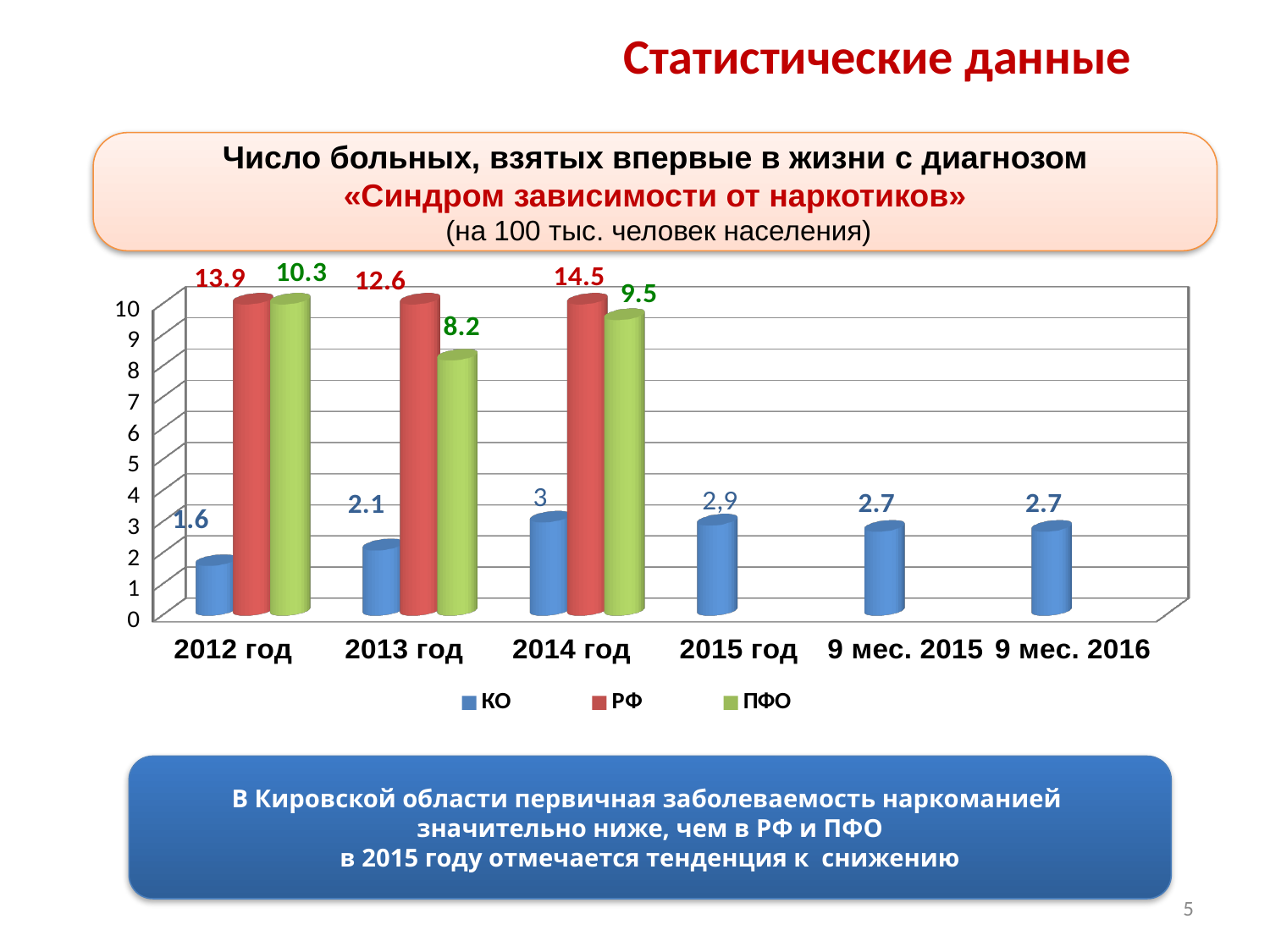
What kind of chart is shown on the slide? Bar chart What is the value for РФ in 2012 год? 13.9 How many categories are shown on the x axis? 6 How many series does the legend list? 3 What is the value for ПФО in 2013 год? 8.2 Which series is shown in red in the legend? РФ In which year is the РФ value highest? 2014 год In which category is the КО value lowest? 2012 год Which is larger in 2013 год: the РФ value or the ПФО value? РФ What is the value for КО in 9 мес. 2016? 2.7 What is the value for КО in 2015 год? 2,9 What is the difference between the РФ and ПФО values in 2014 год? 5